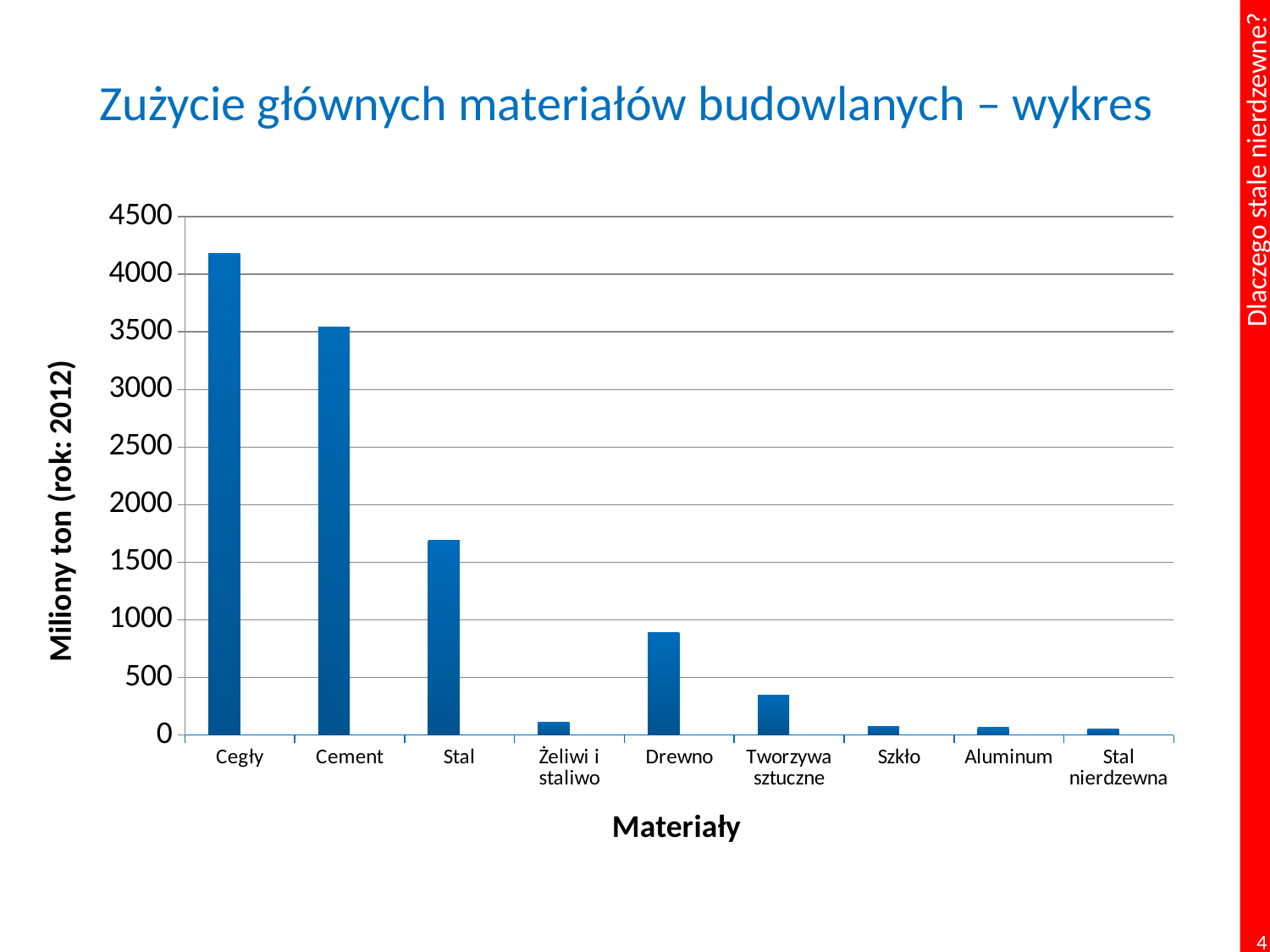
What is the label of the vertical axis of the chart? Miliony ton (rok: 2012) What kind of chart is shown on the slide? bar chart Is the value for Tworzywa sztuczne greater or less than 500? less Is the value for Drewno greater or less than 1000? less How many materials are shown on the x axis of the chart? 9 Which is larger, the value for Cegły or the value for Cement? Cegły Is the value for Cegły greater or less than 4000? greater What is the title of the chart on the slide? Zużycie głównych materiałów budowlanych – wykres Which material has the highest consumption in the chart? Cegły Which is larger, the value for Stal or the value for Drewno? Stal